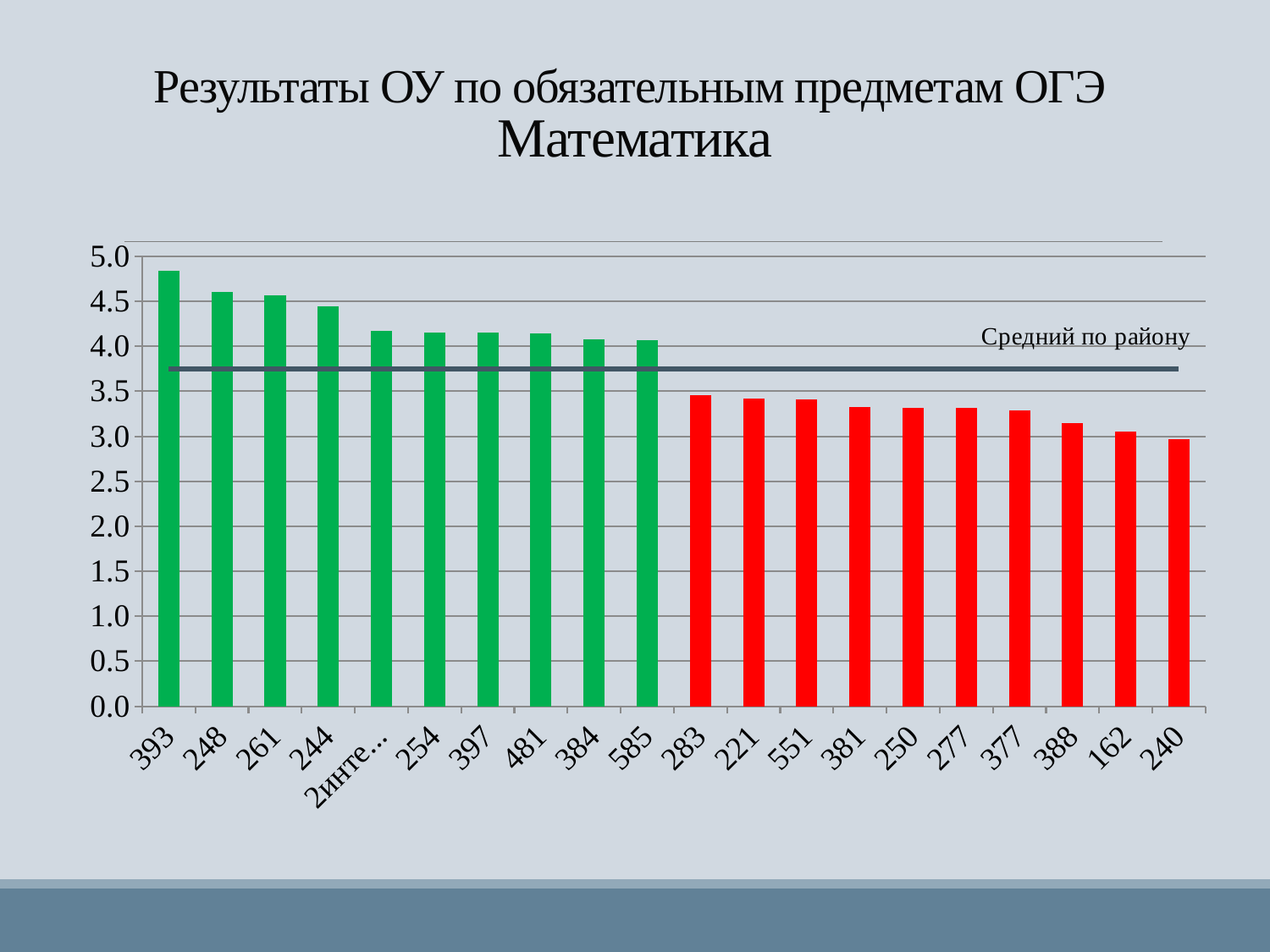
What subject is named in the chart title below 'Результаты ОУ по обязательным предметам ОГЭ'? Математика Which has the larger value, 248 or 283? 248 Is the value for 388 greater or less than 3.0? greater Do the bar values rise or fall from left to right along the x axis? fall Which category has the lowest bar in the chart? 240 Is the value for 393 greater or less than 4.5? greater How many categories are shown on the x axis of the chart? 20 Is the value for 254 greater or less than 4.0? greater What kind of chart is shown on the slide? bar chart What label is given to the horizontal line drawn across the chart? Средний по району Which category has the highest bar in the chart? 393